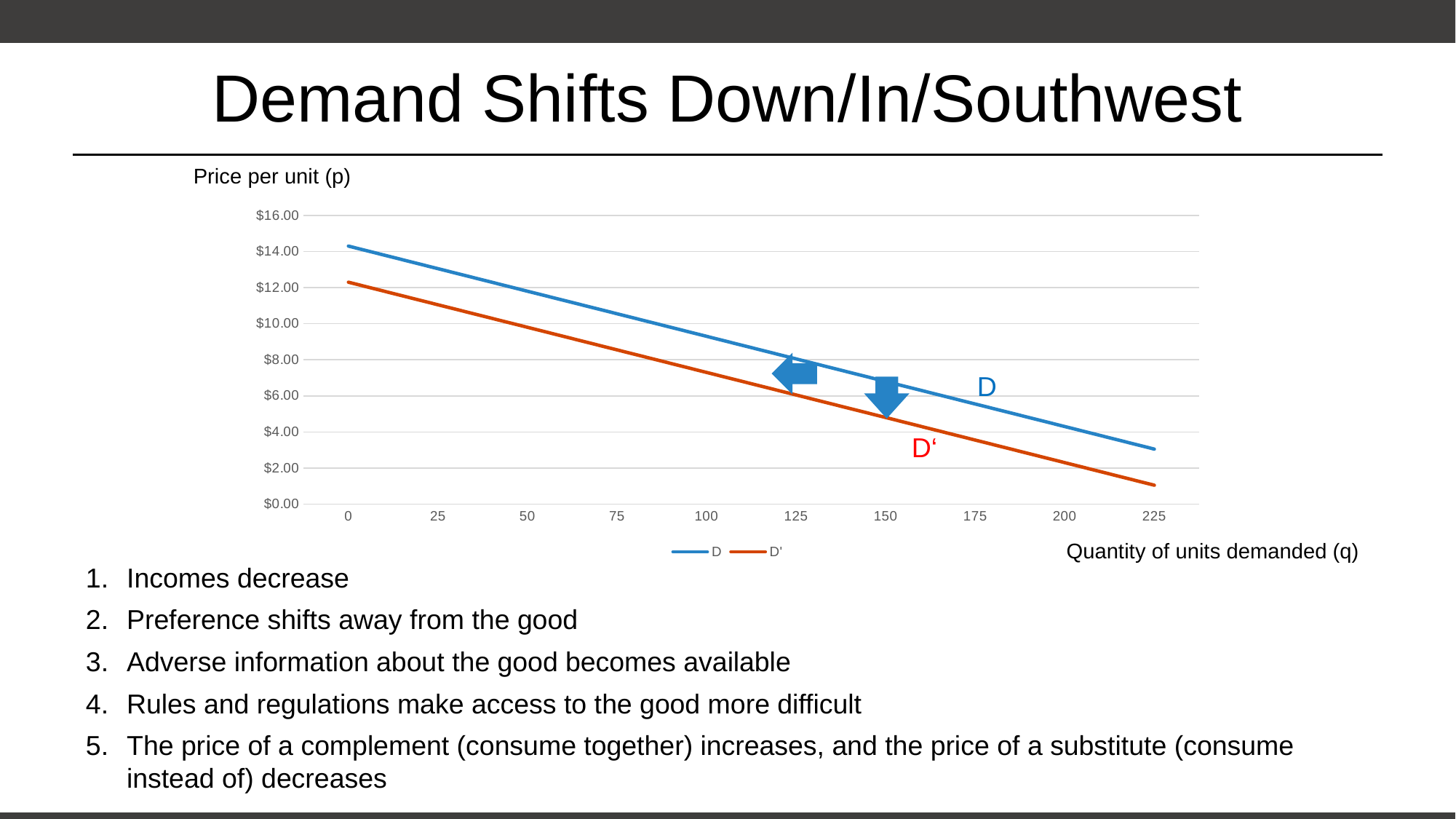
At a quantity of 100, which line is higher, D or D'? D What kind of chart is shown on the slide? line chart Is the value of D' at quantity 100 greater or less than $8.00? less Is the value of D at quantity 225 greater or less than $2.00? greater Is the value of D' at quantity 0 greater or less than $14.00? less How many series does the chart's legend list? 2 Does the D line rise or fall as quantity increases along the x axis? fall What are the two series named in the legend? D and D' How many tick labels are shown on the x axis of the chart? 10 What is the label on the vertical axis of the chart? Price per unit (p)